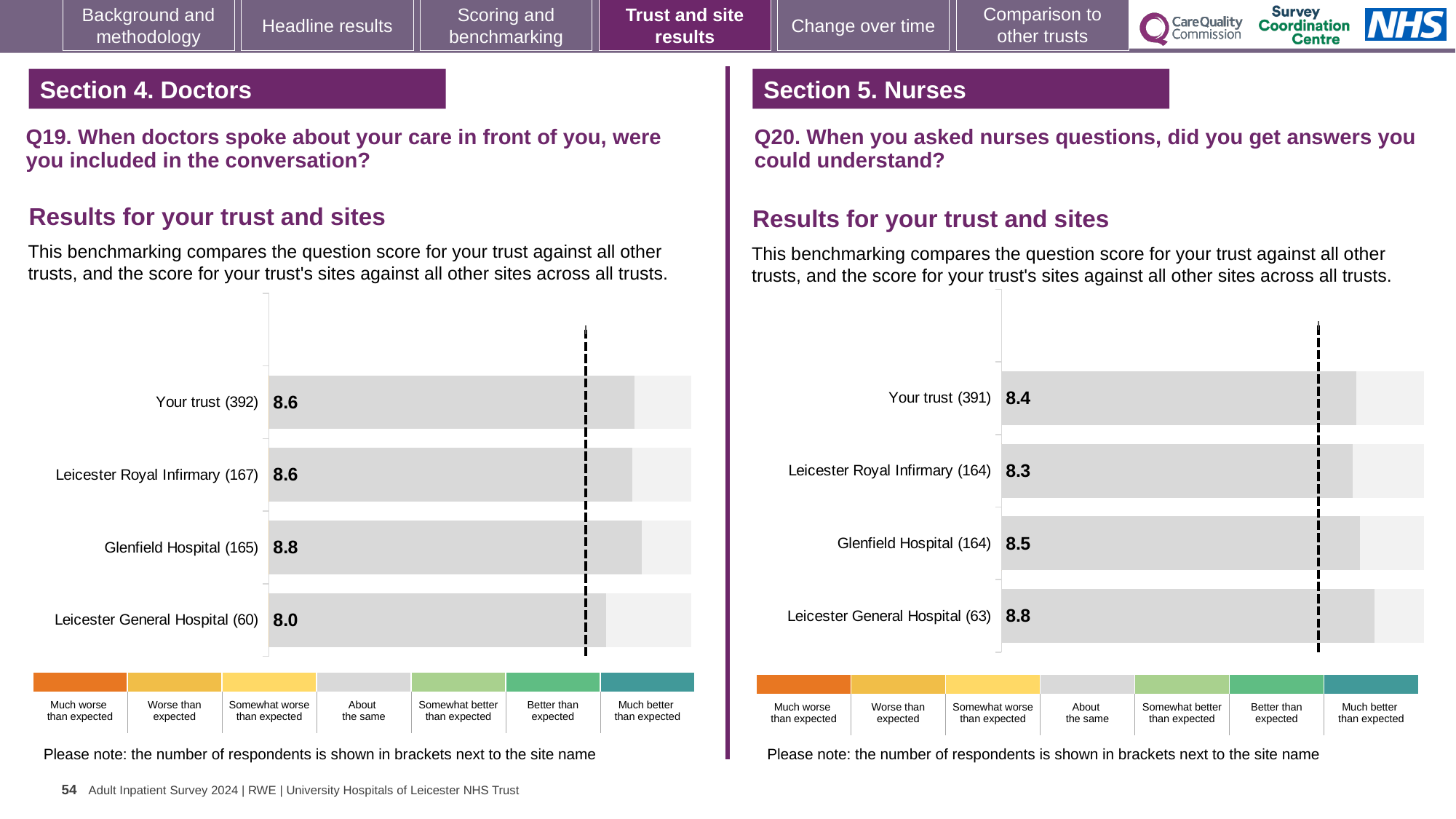
In the Q20 chart on the right, is the score for Glenfield Hospital or Leicester General Hospital larger? Leicester General Hospital In the Q20 chart on the right, what is the score for Leicester Royal Infirmary? 8.3 In the Q20 chart on the right, which site has the highest score? Leicester General Hospital In the Q19 chart on the left, what is the difference between the scores for Glenfield Hospital and Leicester General Hospital? 0.8 In the Q20 chart on the right, what is the score for Your trust? 8.4 In the Q20 chart on the right, how many bars are plotted? 4 In the Q19 chart on the left, which site has the lowest score? Leicester General Hospital In the Q19 chart on the left, what is the score for Glenfield Hospital? 8.8 In the Q19 chart on the left, which site has the highest score? Glenfield Hospital In the Q19 chart on the left, how many respondents are shown for Your trust? 392 In the Q19 chart on the left, what is the score for Leicester General Hospital? 8.0 What kind of chart is used in the Q19 chart on the left? Bar chart